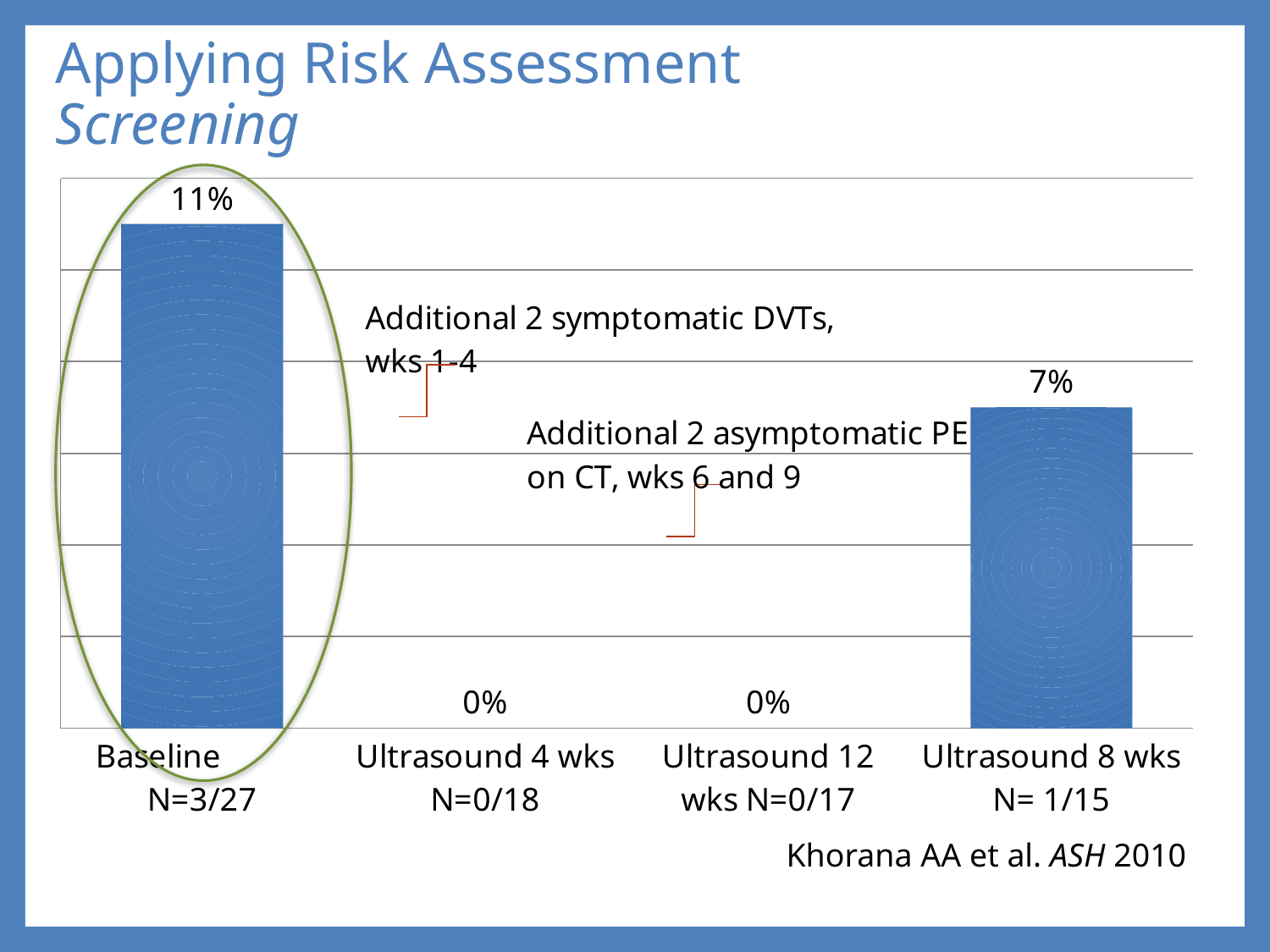
What is the difference between the Baseline value and the Ultrasound 8 wks value? 4% What is the value for Ultrasound 12 wks N=0/17? 0% How many categories have a value of 0%? 2 What is the value for Ultrasound 8 wks N= 1/15? 7% Which category on the chart is circled? Baseline N=3/27 Which category has the highest value? Baseline N=3/27 What kind of chart is shown on the slide? Bar chart How many categories are shown on the x axis? 4 What is the value for Ultrasound 4 wks N=0/18? 0% Which is larger, the value for Baseline or the value for Ultrasound 8 wks? Baseline What is the source cited below the chart? Khorana AA et al. ASH 2010 What is the value for Baseline N=3/27? 11%